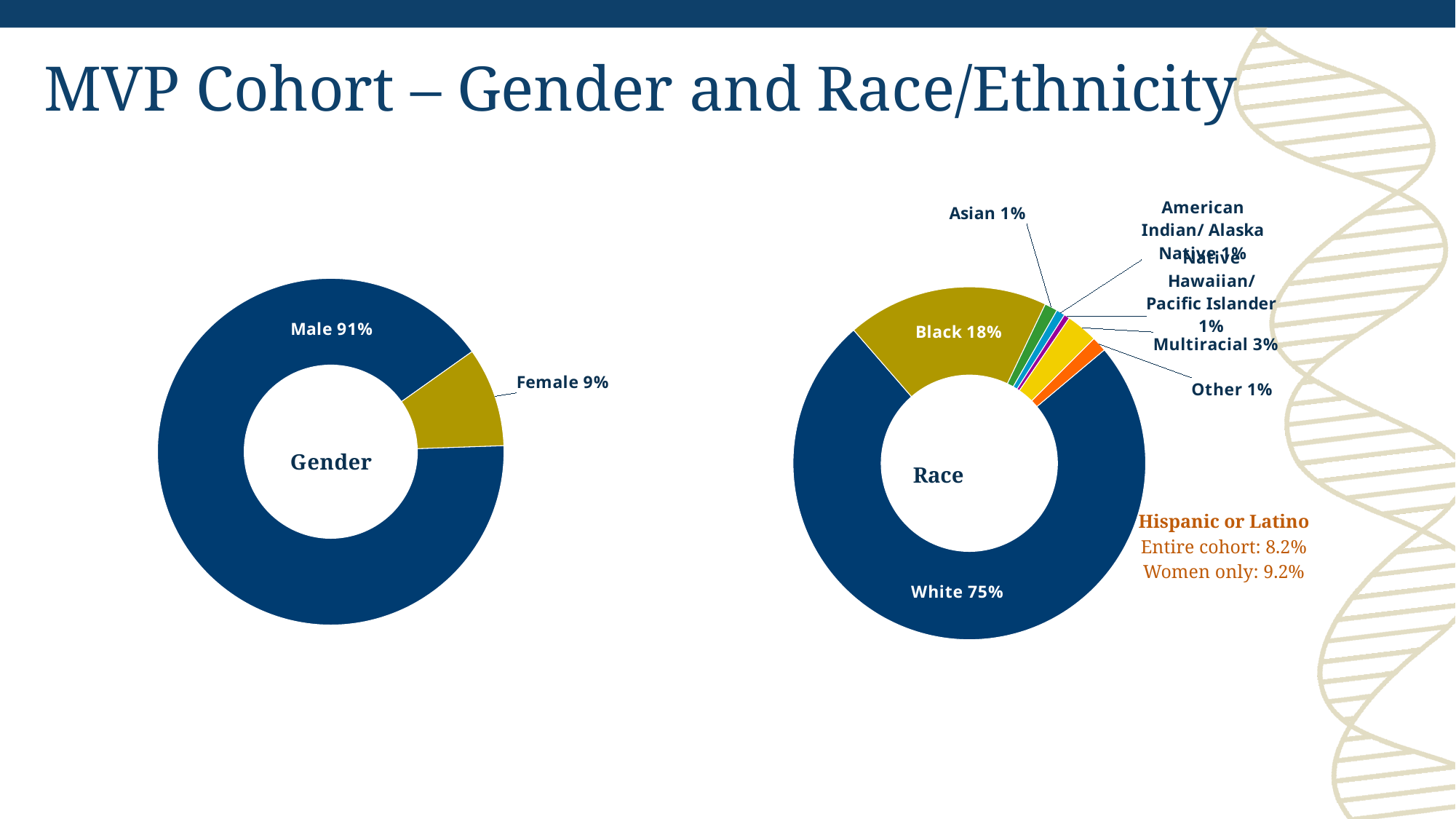
According to the text beside the Race chart, what is the Hispanic or Latino share for the entire cohort? 8.2% In the Gender chart, what is the difference between the Male and Female shares? 82% In the Race chart, what is the difference between the White and Black shares? 57% In the Race chart, which is larger, the Black share or the Multiracial share? Black In the Gender chart, what percentage of the cohort is Female? 9% In the Gender chart, what percentage of the cohort is Male? 91% In the Race chart, which category has the largest share? White How many categories are shown in the Race chart? 7 What kind of chart is the Gender chart? Donut (pie) chart In the Race chart, what percentage of the cohort is Black? 18% In the Race chart, what percentage of the cohort is Multiracial? 3% In the Race chart, what percentage of the cohort is White? 75%